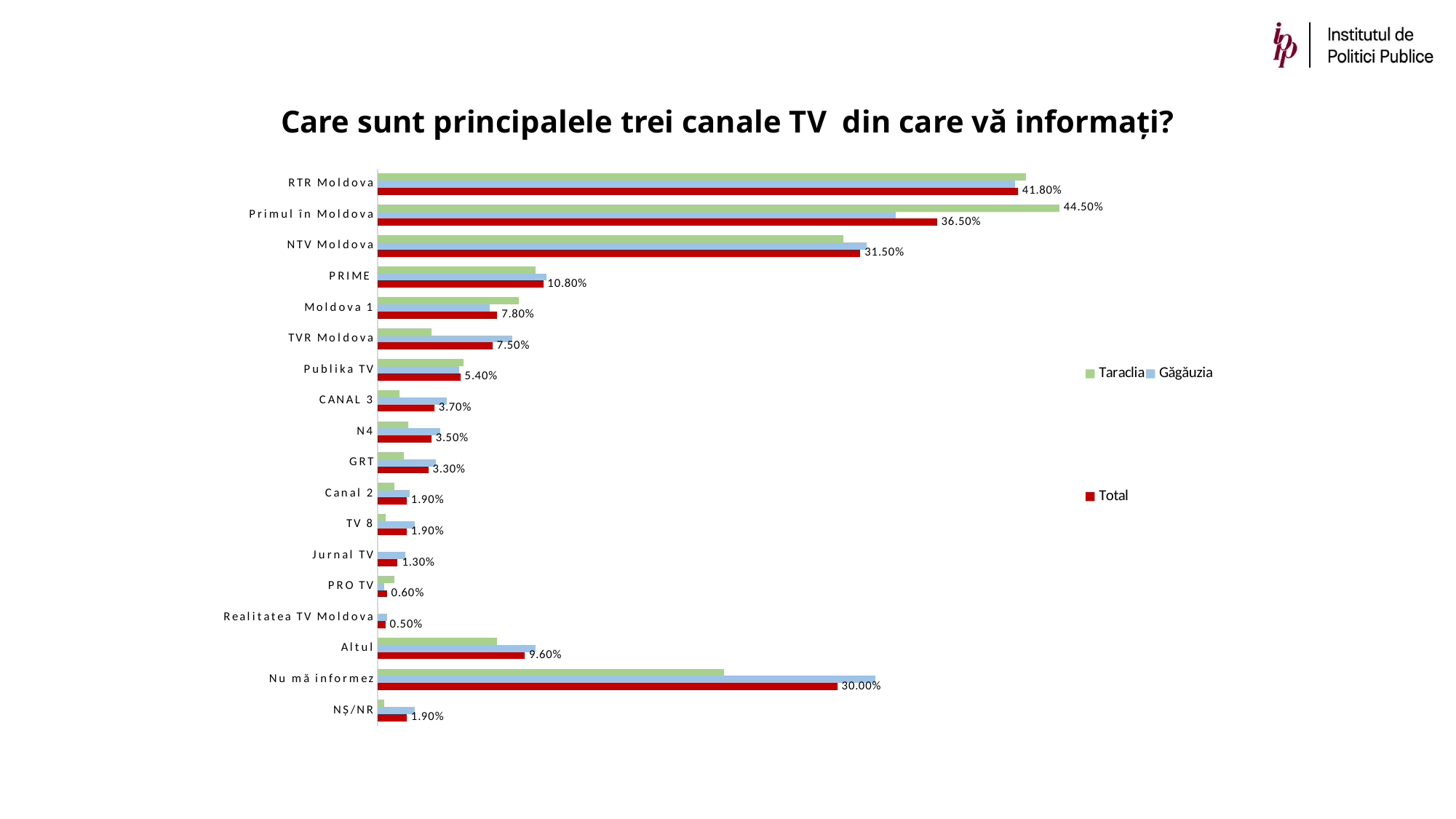
What is the Total value for PRIME? 10.80% Which series is shown in red? Total How many series does the legend list? 3 What is the difference between the Total values for RTR Moldova and Primul în Moldova? 5.30% Which has the larger Total value, PRIME or Altul? PRIME Which category has the highest Total value? RTR Moldova Which category has the lowest Total value? Realitatea TV Moldova How many categories are shown on the chart? 18 What is the Total value for Realitatea TV Moldova? 0.50% What is the Total value for Nu mă informez? 30.00% What is the Total value for RTR Moldova? 41.80% What kind of chart is shown on the slide? Bar chart